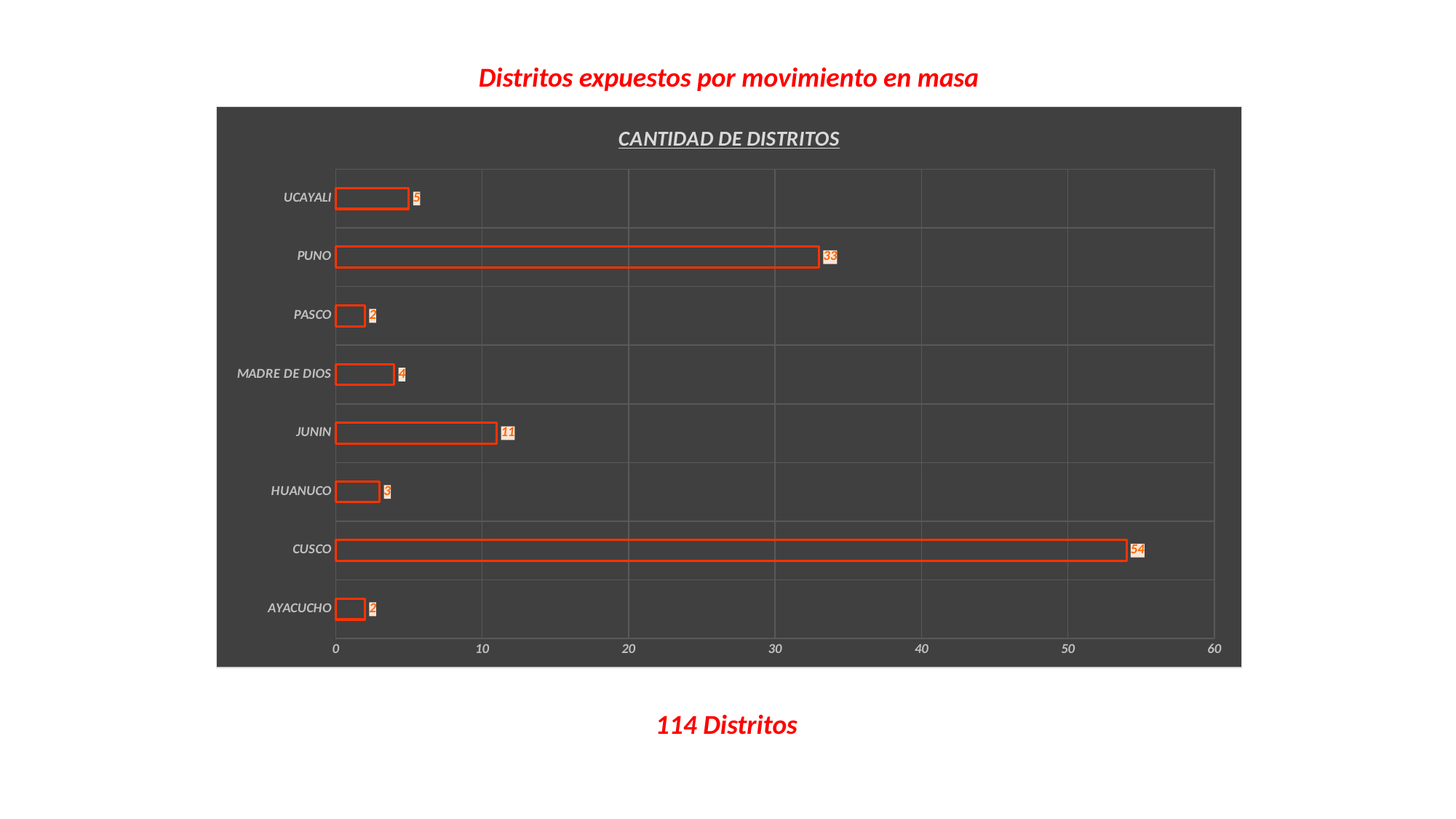
What is the difference between the values for UCAYALI and HUANUCO? 2 What kind of chart is shown on the slide? bar chart Which is larger, the value for JUNIN or the value for UCAYALI? JUNIN What is the value for MADRE DE DIOS? 4 Is the value for PUNO greater or less than 30? greater What is the title of the chart? CANTIDAD DE DISTRITOS What is the difference between the values for CUSCO and PUNO? 21 Which category has the highest value? CUSCO What is the value for JUNIN? 11 How many categories are shown in the chart? 8 What is the value for CUSCO? 54 What is the value for PUNO? 33